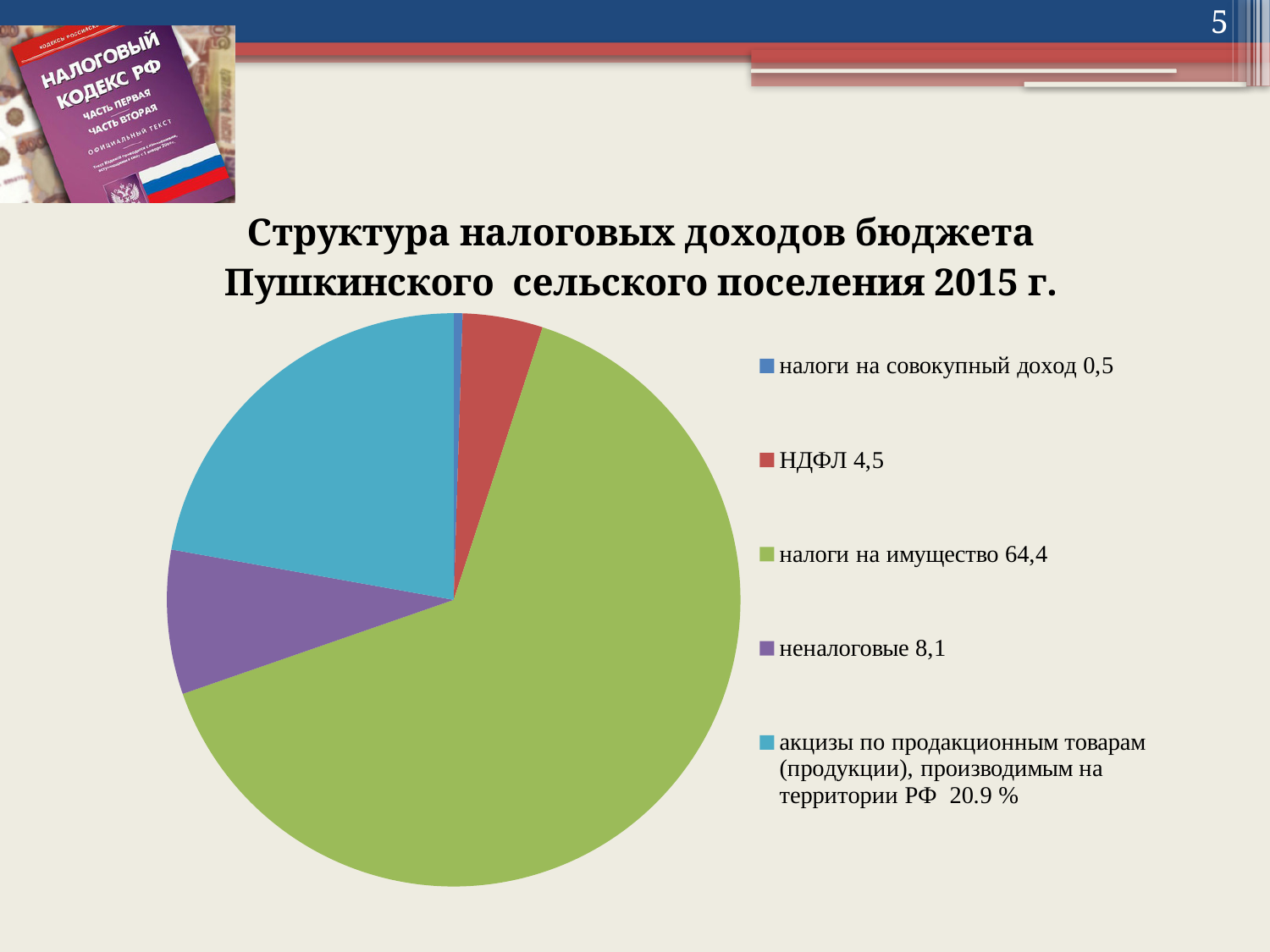
What is the value shown for налоги на имущество? 64,4 What is the value shown for неналоговые? 8,1 What is the value shown for НДФЛ? 4,5 What is the value shown for налоги на совокупный доход? 0,5 Which category has the largest slice of the pie? налоги на имущество What share of the pie do акцизы по продакционным товарам (продукции), производимым на территории РФ account for? 20.9 % Which is larger, the value for неналоговые or the value for НДФЛ? неналоговые Which category has the smallest slice of the pie? налоги на совокупный доход What colour is the slice for налоги на имущество? green What kind of chart is shown on the slide? pie chart How many slices does the pie chart have? 5 What is the difference between the values for неналоговые and НДФЛ? 3,6